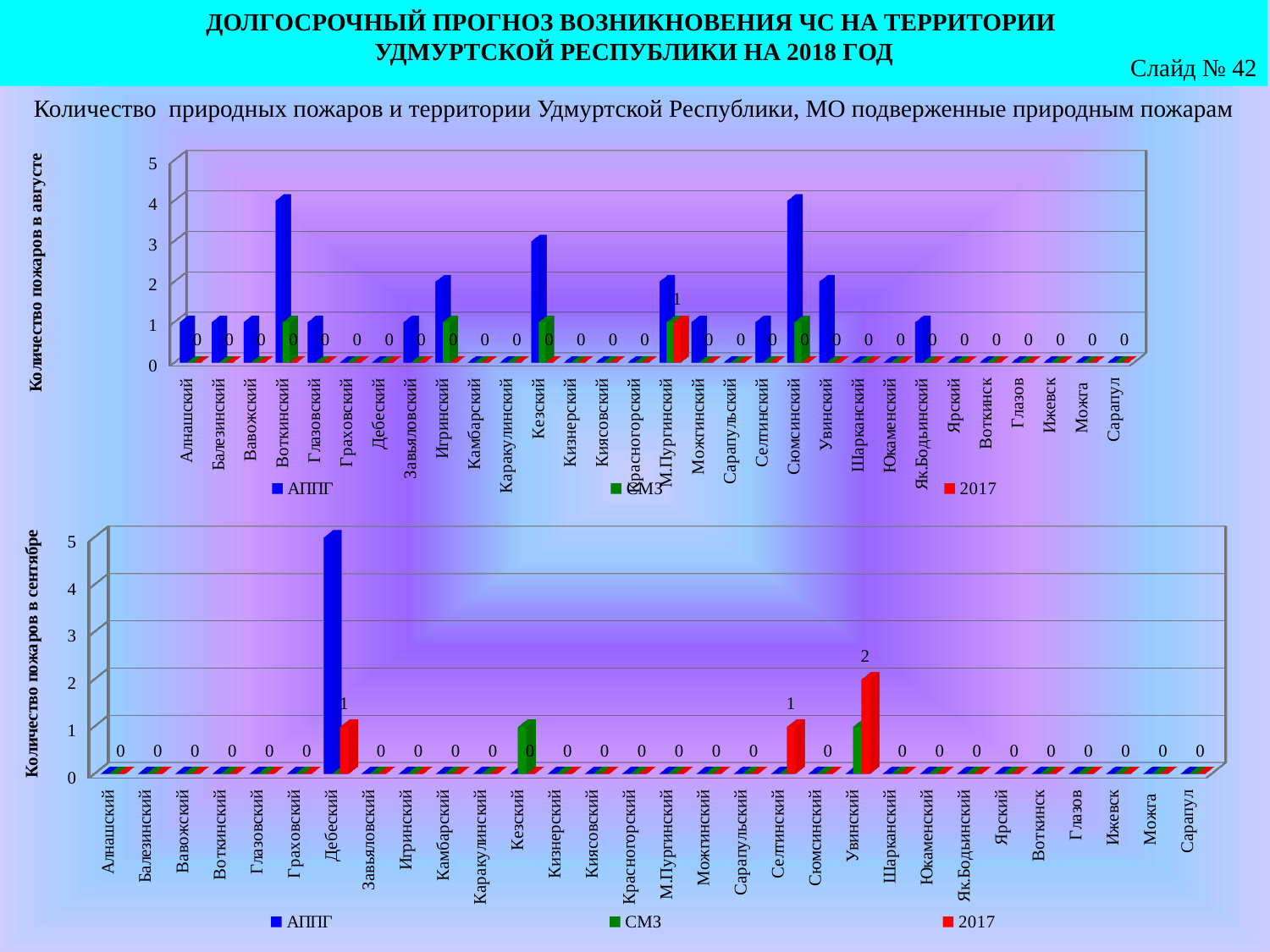
In the bottom chart (Количество пожаров в сентябре), what is the 2017 value for Дебесский? 1 In the bottom chart (Количество пожаров в сентябре), which has the larger 2017 value, Увинский or Селтинский? Увинский In the bottom chart (Количество пожаров в сентябре), is the АППГ value for Дебесский greater or less than 4? greater How many series does the legend of the bottom chart (Количество пожаров в сентябре) list? 3 In the bottom chart (Количество пожаров в сентябре), what is the 2017 value for Увинский? 2 In the top chart (Количество пожаров в августе), what is the 2017 value for М.Пургинский? 1 In the top chart (Количество пожаров в августе), is the АППГ value for Воткинский greater or less than 3? greater In the bottom chart (Количество пожаров в сентябре), which category has the highest АППГ value? Дебесский In the top chart (Количество пожаров в августе), which has the larger АППГ value, Кезский or Игринский? Кезский What are the legend entries of the top chart (Количество пожаров в августе)? АППГ, СМЗ, 2017 In the bottom chart (Количество пожаров в сентябре), what is the 2017 value for Селтинский? 1 What kind of chart is the top chart (Количество пожаров в августе)? bar chart